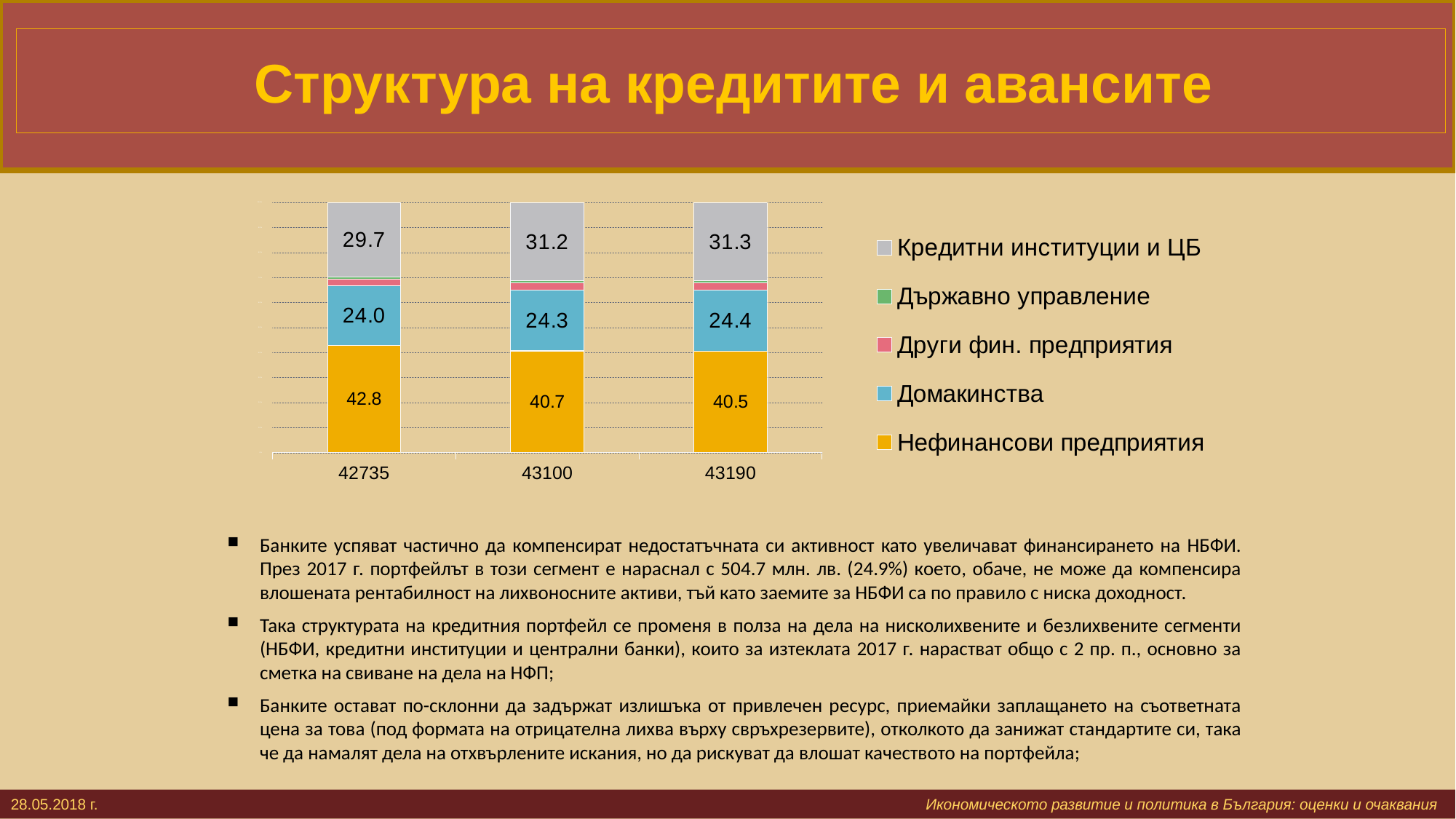
Which legend entry is shown in yellow/orange? Нефинансови предприятия For which category is the value of Нефинансови предприятия the highest? 42735 For which category is the value of Кредитни институции и ЦБ the lowest? 42735 Which is larger for the category 43100: the value of Домакинства or the value of Кредитни институции и ЦБ? Кредитни институции и ЦБ What kind of chart is shown on the slide? stacked bar chart What is the difference between the Нефинансови предприятия values for 42735 and 43190? 2.3 What is the value of Кредитни институции и ЦБ for the category 43100? 31.2 How many series does the chart legend list? 5 What is the value of Нефинансови предприятия for the category 42735? 42.8 Do the values of Нефинансови предприятия rise or fall from 42735 to 43190? fall How many bars (categories) are shown on the x axis of the chart? 3 What is the value of Домакинства for the category 43190? 24.4